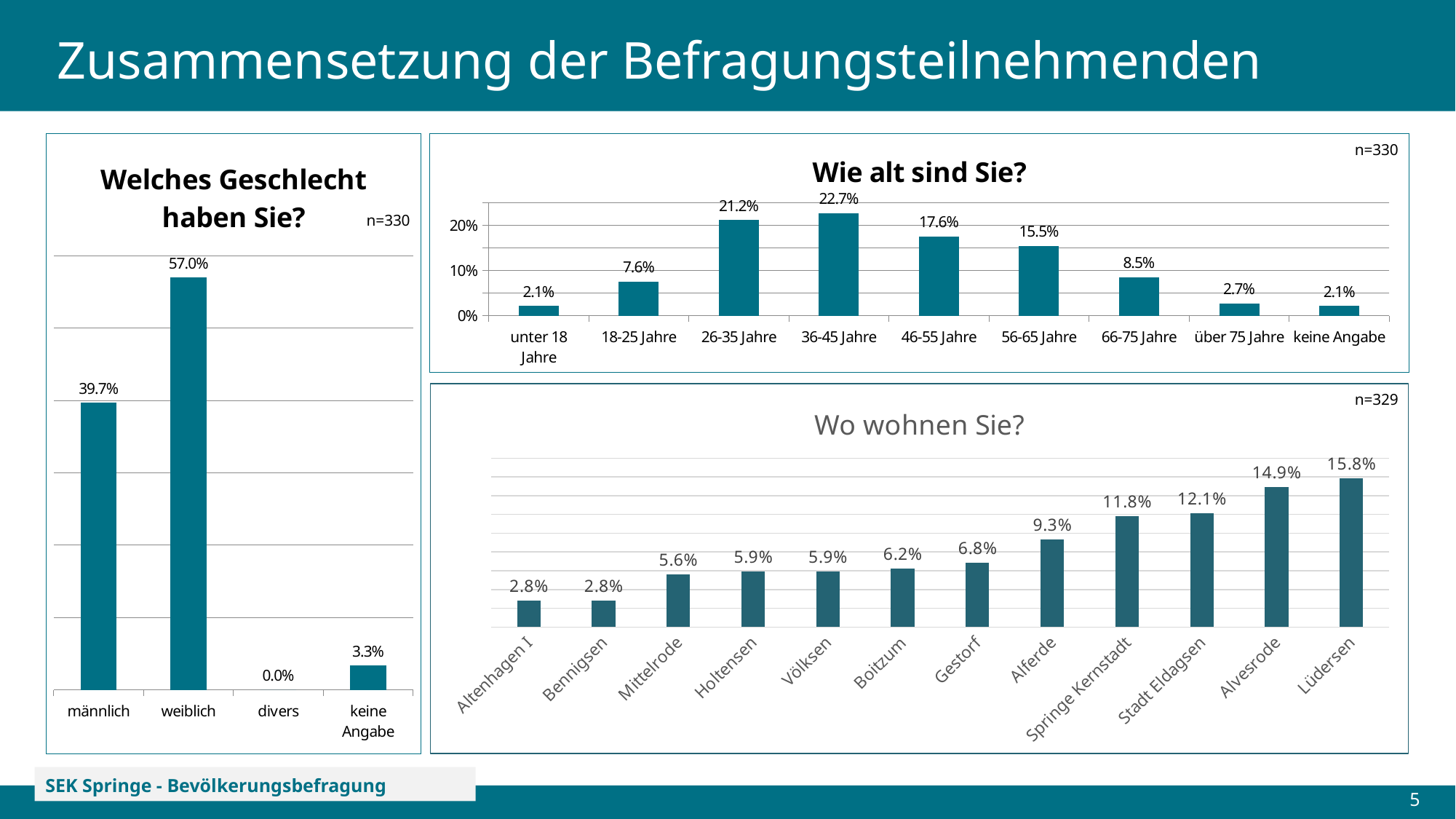
In the chart 'Welches Geschlecht haben Sie?', how many categories are shown on the x axis? 4 In the chart 'Wie alt sind Sie?', how many categories are shown on the x axis? 9 In the chart 'Welches Geschlecht haben Sie?', what is the value for weiblich? 57.0% What kind of chart is 'Wo wohnen Sie?'? bar chart In the chart 'Wie alt sind Sie?', what is the value for 56-65 Jahre? 15.5% In the chart 'Wie alt sind Sie?', which is larger, 18-25 Jahre or 66-75 Jahre? 66-75 Jahre In the chart 'Wo wohnen Sie?', which place has the highest value? Lüdersen In the chart 'Welches Geschlecht haben Sie?', what is the difference between weiblich and männlich? 17.3% In the chart 'Wo wohnen Sie?', what is the difference between Alvesrode and Alferde? 5.6% In the chart 'Wo wohnen Sie?', what is the value for Springe Kernstadt? 11.8% In the chart 'Wie alt sind Sie?', which age group has the highest value? 36-45 Jahre In the chart 'Wo wohnen Sie?', do the values rise or fall from left to right along the x axis? rise